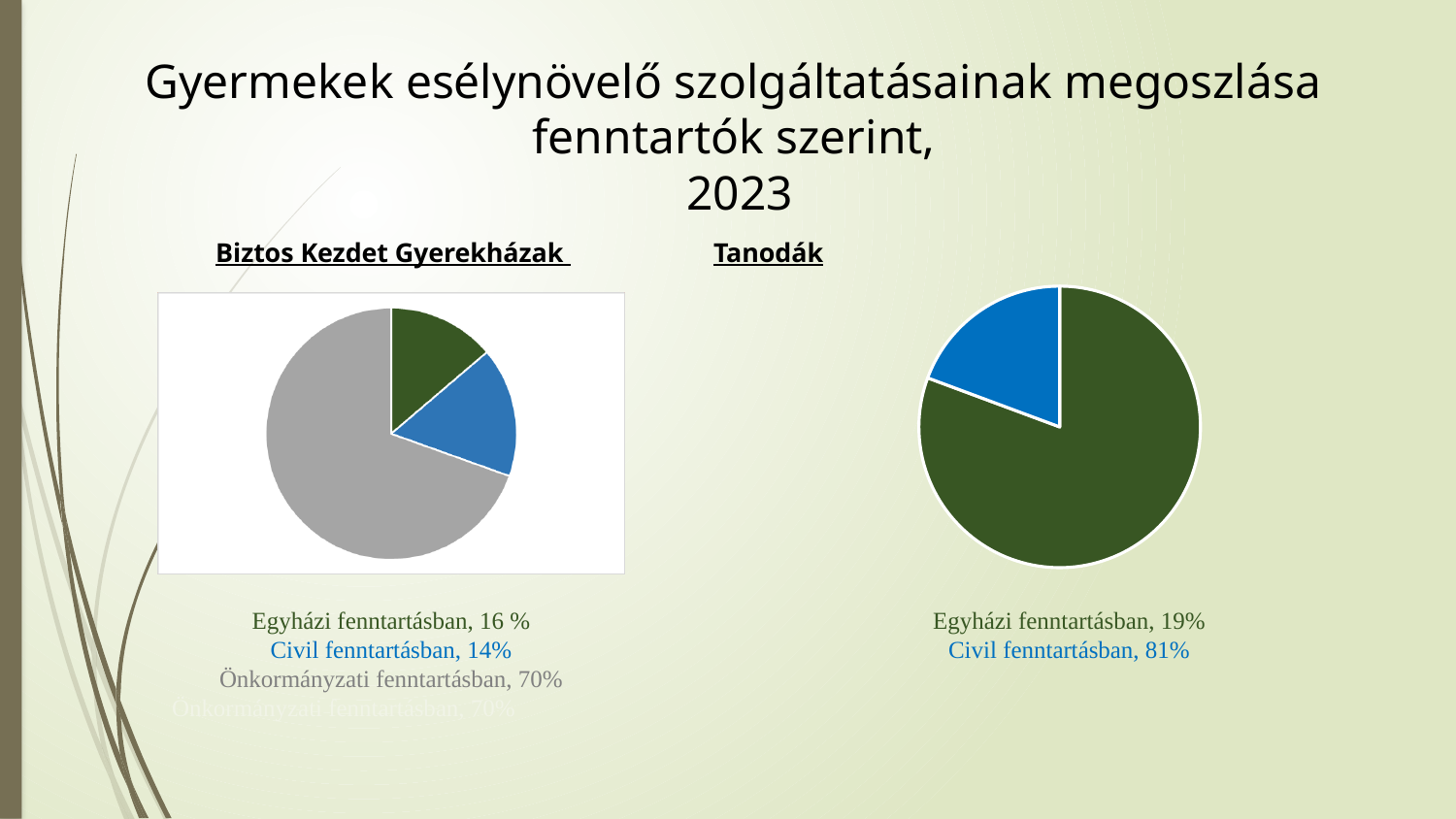
In the Tanodák chart, what share is Civil fenntartásban? 81% What type of chart is the Tanodák chart? Pie chart In the Biztos Kezdet Gyerekházak chart, what share is Civil fenntartásban? 14% In the Tanodák chart, what share is Egyházi fenntartásban? 19% In the Biztos Kezdet Gyerekházak chart, what share is Önkormányzati fenntartásban? 70% In the Biztos Kezdet Gyerekházak chart, which category has the largest share? Önkormányzati fenntartásban How many charts are on the slide? 2 In the Biztos Kezdet Gyerekházak chart, how many categories are shown? 3 In the Tanodák chart, which category has the larger share? Civil fenntartásban In the Biztos Kezdet Gyerekházak chart, what share is Egyházi fenntartásban? 16 % In the Biztos Kezdet Gyerekházak chart, which category has the smallest share? Civil fenntartásban In the Tanodák chart, what is the difference between the Civil fenntartásban and Egyházi fenntartásban shares? 62 percentage points